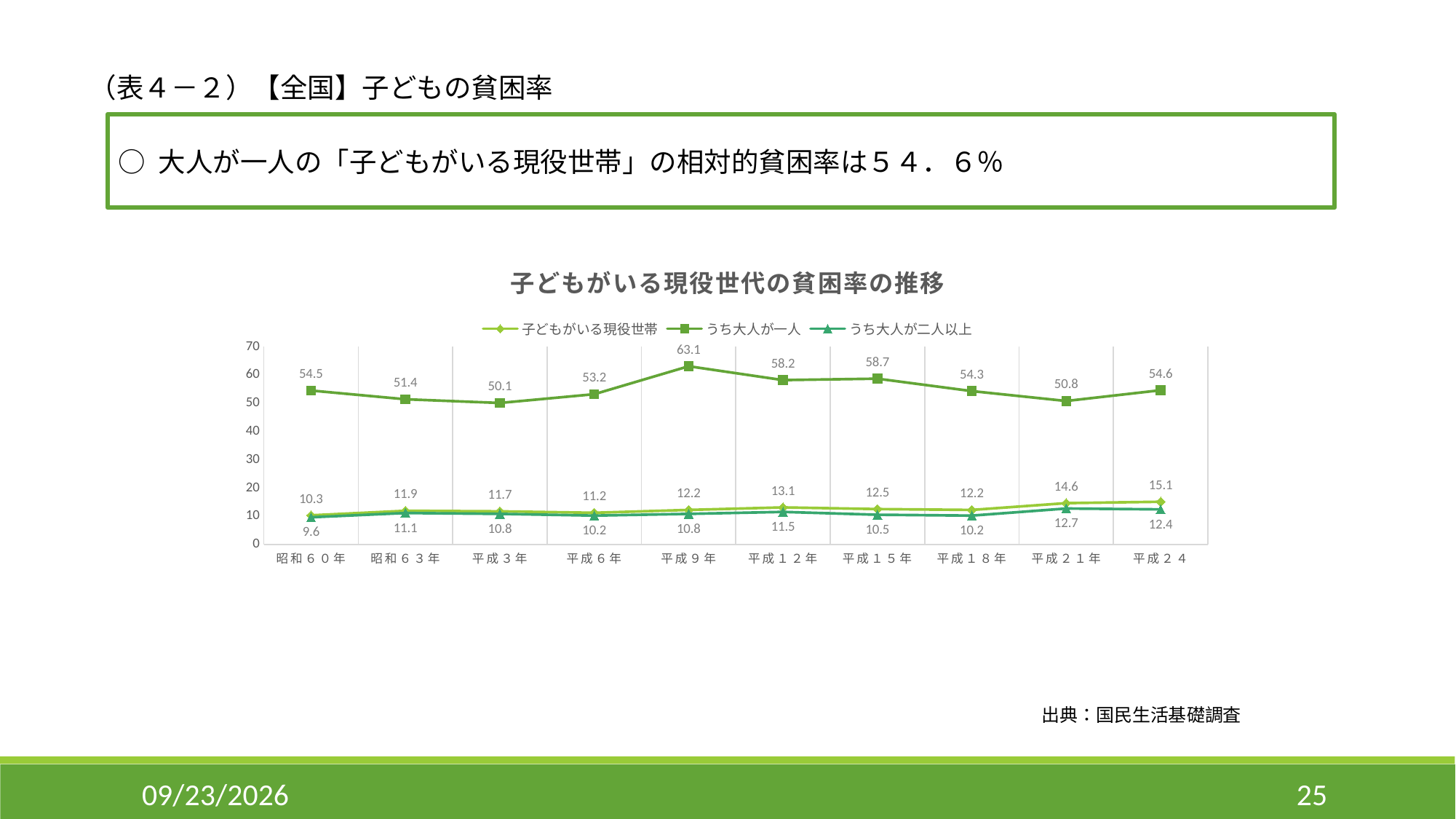
What is the value for 子どもがいる現役世帯 in 昭和６０年? 10.3 What is the value for うち大人が二人以上 in 平成２１年? 12.7 In which year is the value for うち大人が一人 highest? 平成９年 What kind of chart is shown on the slide? line chart In which year is the value for うち大人が一人 lowest? 平成３年 How many series does the legend list? 3 What is the difference between the うち大人が一人 values in 平成９年 and 平成２１年? 12.3 How many time points are plotted along the x axis? 10 What is the value for うち大人が一人 in 平成２４? 54.6 What is the value for うち大人が一人 in 平成９年? 63.1 Which is larger in 平成２４: the value for 子どもがいる現役世帯 or うち大人が二人以上? 子どもがいる現役世帯 What is the title of the chart? 子どもがいる現役世代の貧困率の推移